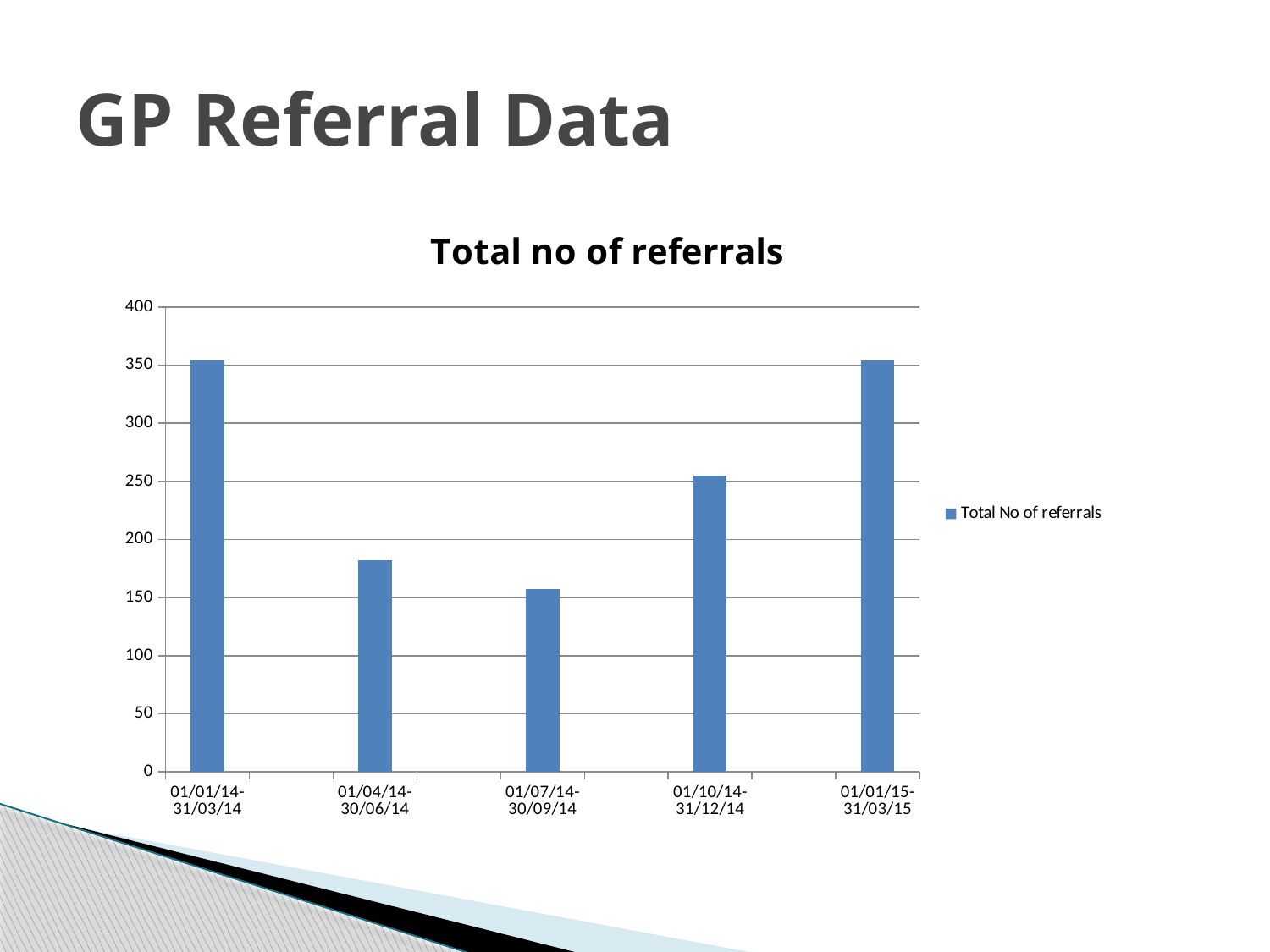
Do the values rise or fall from 01/07/14-30/09/14 to 01/01/15-31/03/15? rise What kind of chart is shown on the slide? bar chart What series name is shown in the chart's legend? Total No of referrals Is the value for 01/07/14-30/09/14 greater or less than 200? less What is the title of the chart? Total no of referrals Which has more referrals, 01/04/14-30/06/14 or 01/10/14-31/12/14? 01/10/14-31/12/14 How many series does the chart's legend list? 1 Which time period has the lowest total number of referrals? 01/07/14-30/09/14 Is the value for 01/04/14-30/06/14 greater or less than 250? less Is the value for 01/01/14-31/03/14 greater or less than 300? greater How many time periods are shown on the x axis of the chart? 5